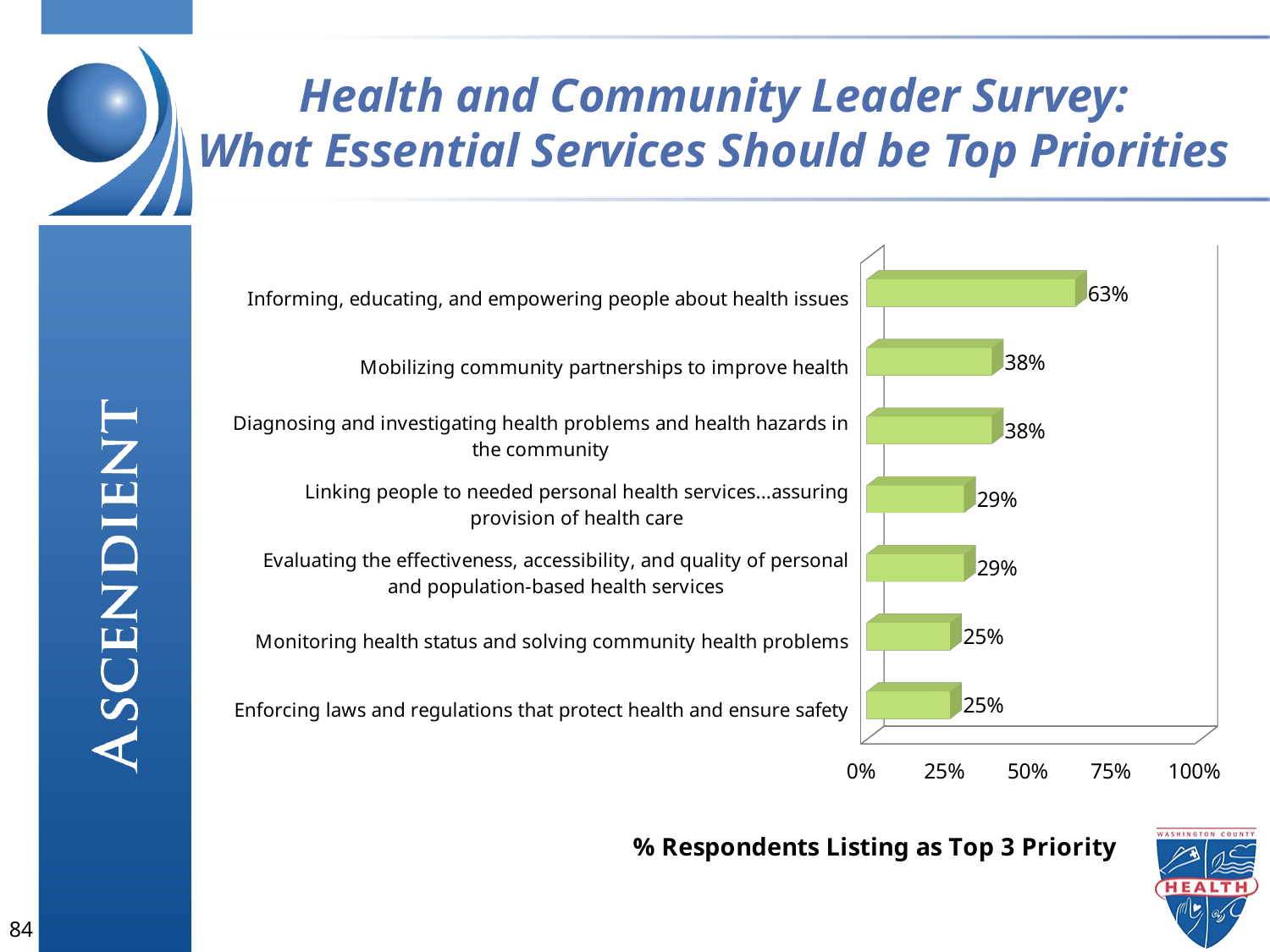
What is the value for 'Monitoring health status and solving community health problems'? 25% How many essential services are shown in the chart? 7 What is the value for 'Mobilizing community partnerships to improve health'? 38% What is the label shown below the chart's x axis? % Respondents Listing as Top 3 Priority What percentage of respondents listed 'Informing, educating, and empowering people about health issues' as a top 3 priority? 63% Which essential service has the highest percentage of respondents listing it as a top 3 priority? Informing, educating, and empowering people about health issues Is the value for 'Informing, educating, and empowering people about health issues' greater or less than 50%? greater What kind of chart is shown on the slide? Bar chart What is the difference between the value for 'Informing, educating, and empowering people about health issues' and the value for 'Mobilizing community partnerships to improve health'? 25% Which is larger: the value for 'Diagnosing and investigating health problems and health hazards in the community' or the value for 'Enforcing laws and regulations that protect health and ensure safety'? Diagnosing and investigating health problems and health hazards in the community What is the difference between the value for 'Evaluating the effectiveness, accessibility, and quality of personal and population-based health services' and the value for 'Monitoring health status and solving community health problems'? 4% What is the value for 'Linking people to needed personal health services...assuring provision of health care'? 29%